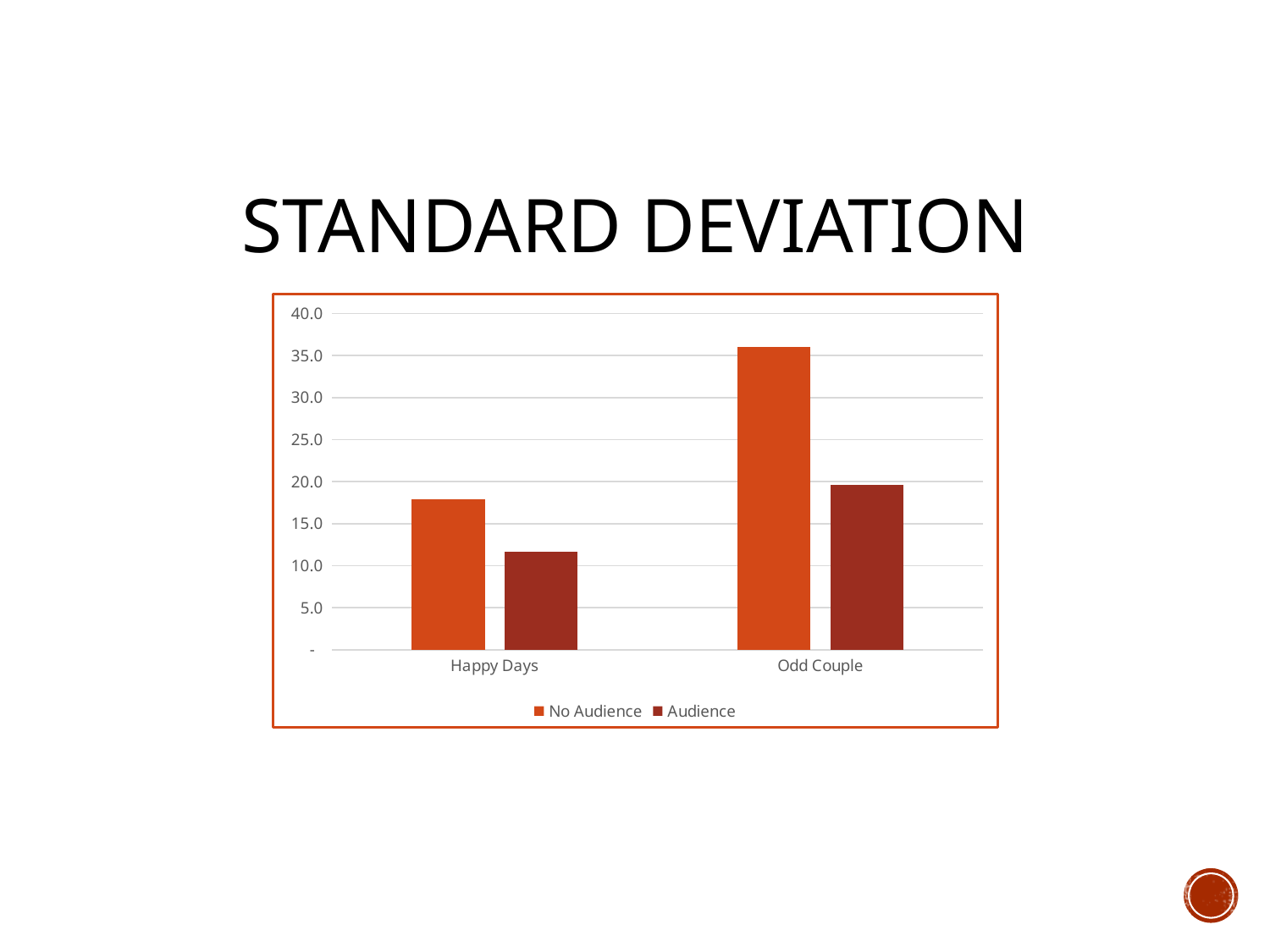
What are the two series named in the chart's legend? No Audience and Audience What kind of chart is shown on the slide? bar chart Which is larger: the No Audience value for Odd Couple or the No Audience value for Happy Days? Odd Couple Is the Audience value for Happy Days greater or less than 15? less Is the Audience value for Odd Couple greater or less than 15? greater How many series does the chart's legend list? 2 Is the No Audience value for Happy Days greater or less than 15? greater Which category has the highest No Audience bar? Odd Couple Which bar is the lowest in the chart? Audience for Happy Days How many categories are shown on the x axis of the chart? 2 For Odd Couple, which series has the larger value, No Audience or Audience? No Audience